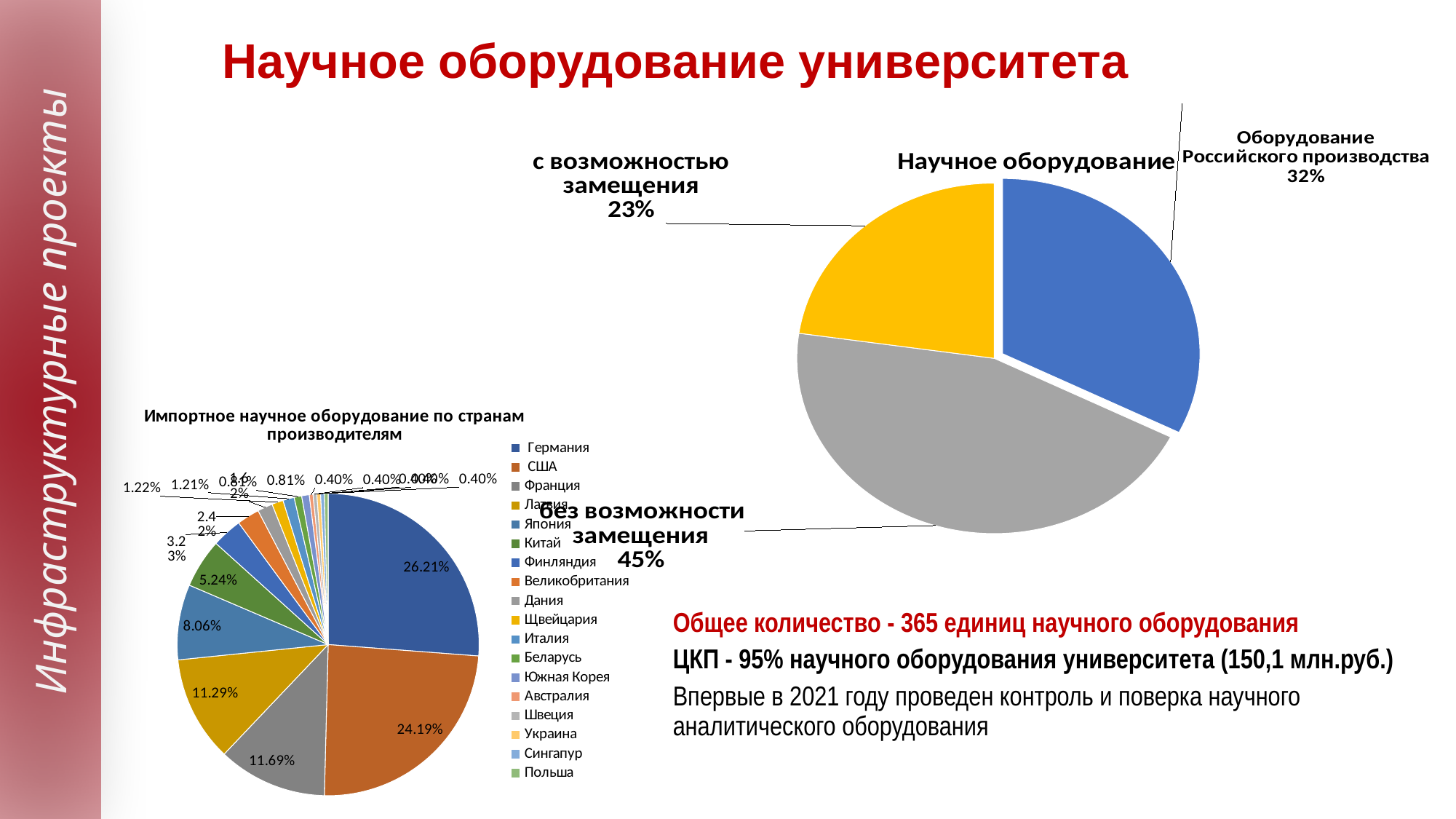
In the 'Научное оборудование' pie chart, how many slices are there? 3 In the 'Импортное научное оборудование по странам производителям' chart, how many countries does the legend list? 18 In the 'Научное оборудование' pie chart, which slice is the smallest? с возможностью замещения In the 'Научное оборудование' pie chart, which slice is the largest? без возможности замещения In the 'Научное оборудование' pie chart, what share is 'с возможностью замещения'? 23% In the 'Научное оборудование' pie chart, what share is 'без возможности замещения'? 45% In the 'Импортное научное оборудование по странам производителям' chart, what share does Германия have? 26.21% In the 'Импортное научное оборудование по странам производителям' chart, which country has the largest share? Германия In the 'Импортное научное оборудование по странам производителям' chart, what share does США have? 24.19% What type of chart is 'Импортное научное оборудование по странам производителям'? pie chart In the 'Научное оборудование' pie chart, what share is 'Оборудование Российского производства'? 32% In the 'Научное оборудование' pie chart, what is the difference between 'без возможности замещения' and 'Оборудование Российского производства'? 13%